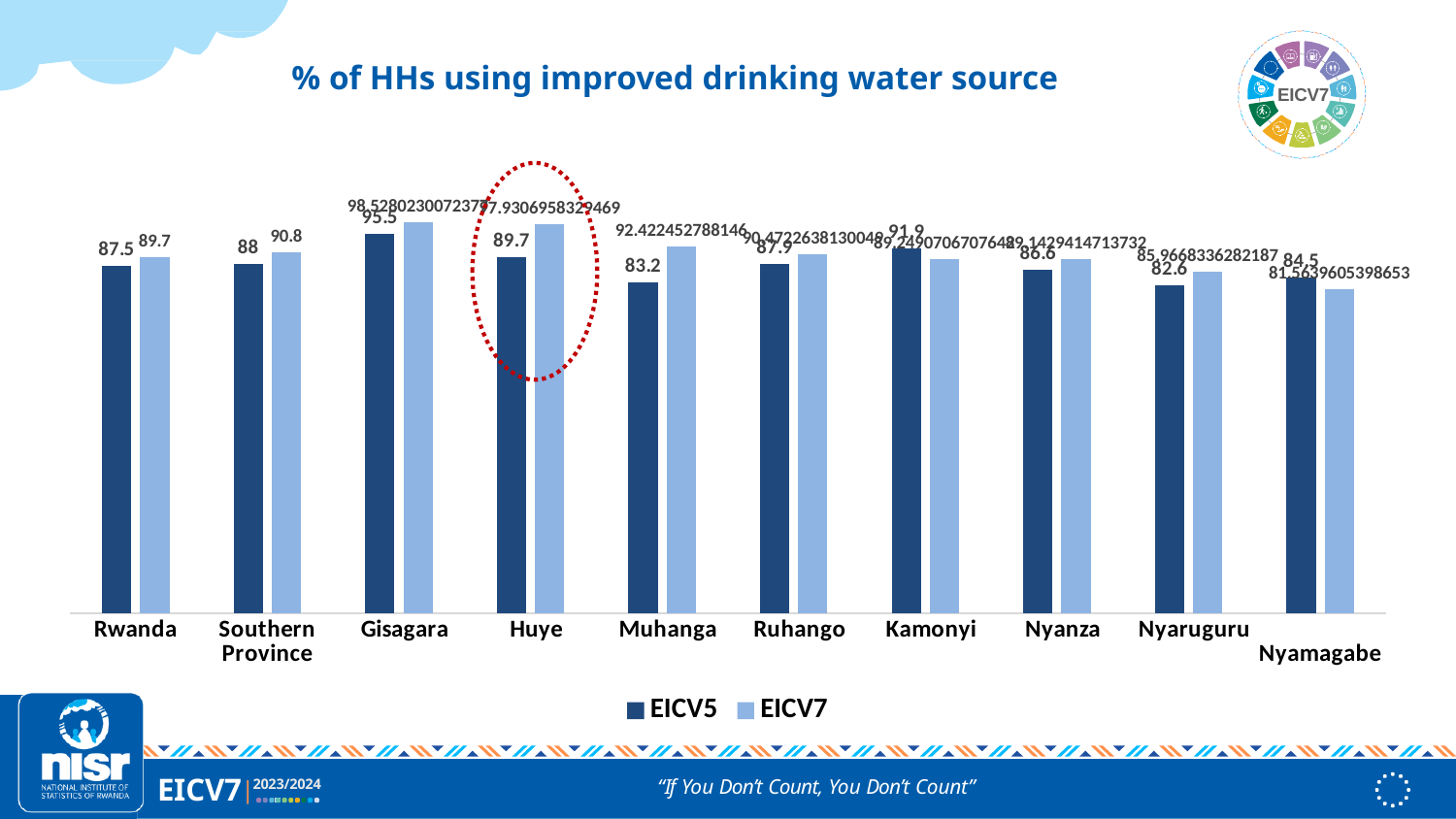
What is the EICV5 value for Huye? 89.7 What is the difference between the EICV7 and EICV5 values for Rwanda? 2.2 What kind of chart is shown on the slide? Bar chart Which category has the lowest EICV5 value? Nyaruguru What is the EICV5 value for Muhanga? 83.2 What is the EICV5 value for Kamonyi? 91.9 For Nyamagabe, which series has the larger value, EICV5 or EICV7? EICV5 Which category has the highest EICV5 value? Gisagara How many series does the legend list? 2 How many categories are shown on the x axis? 10 What is the EICV5 value for Rwanda? 87.5 What is the EICV7 value for Southern Province? 90.8